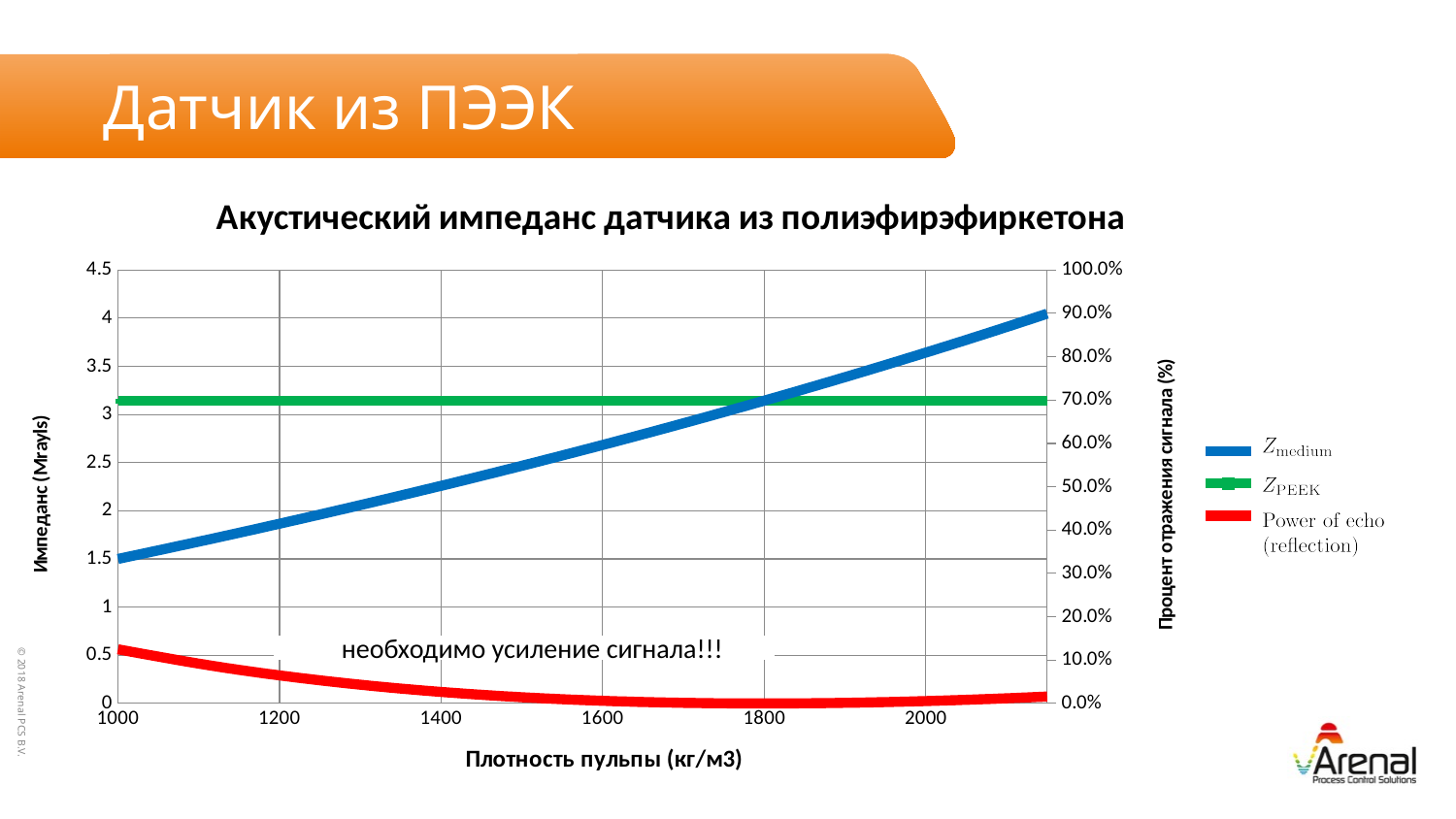
What is the title of the chart? Акустический импеданс датчика из полиэфирэфиркетона Does the Z_medium line rise or fall as pulp density increases along the x axis? rises Is the value of Z_PEEK greater or less than 3 Mrayls? greater What kind of chart is shown on the slide? line chart Is the value of Z_medium at a density of 1000 greater or less than 2 Mrayls? less Does the Power of echo (reflection) line rise or fall between 1000 and 1600 on the x axis? falls At a density of 1000, which is larger: Z_medium or Z_PEEK? Z_PEEK Is the Power of echo (reflection) at a density of 1000 greater or less than 20.0%? less How many series does the legend list? 3 At a density of 2000, which is larger: Z_medium or Z_PEEK? Z_medium What is the label of the x axis? Плотность пульпы (кг/м3)